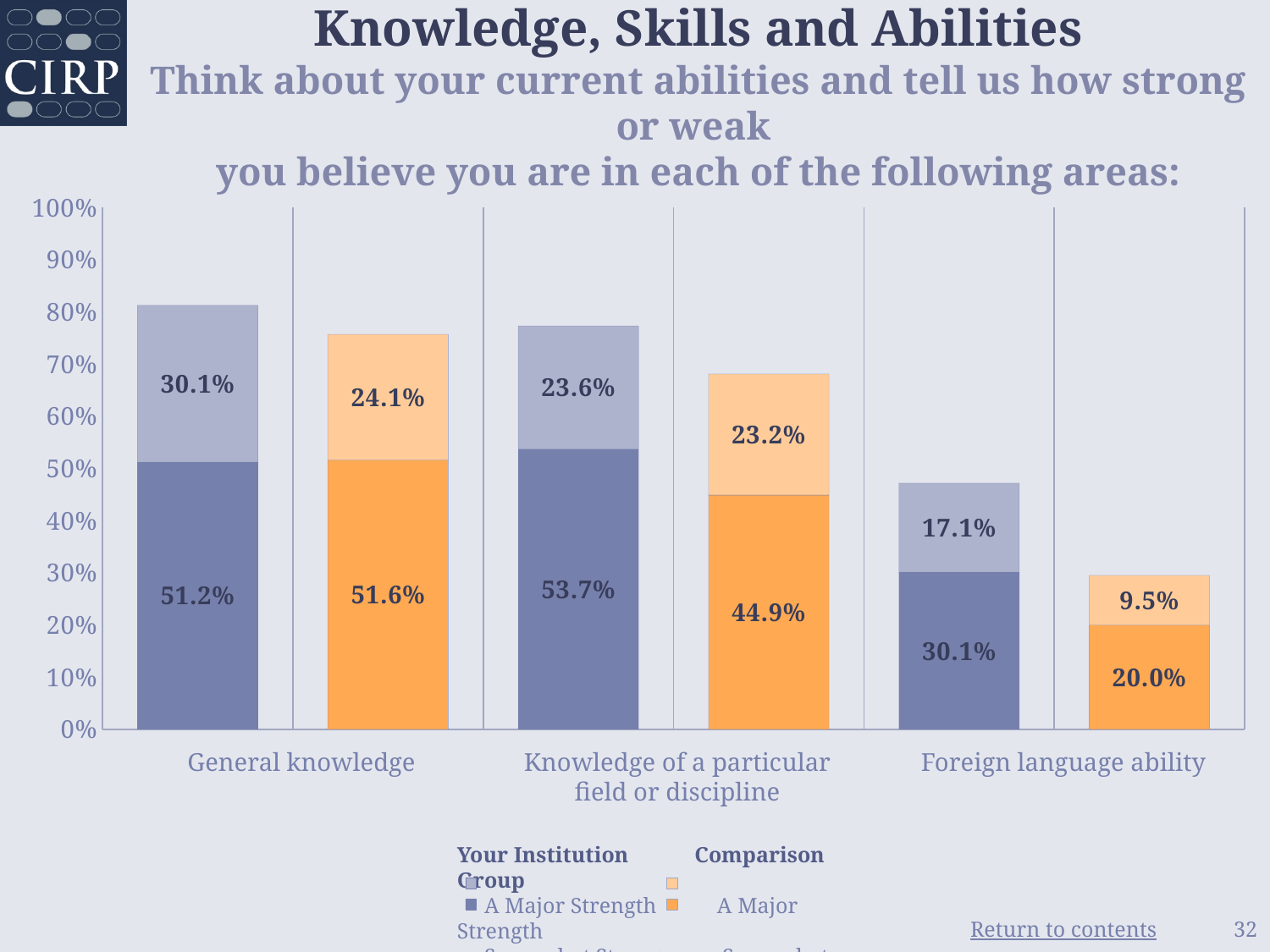
Which colour represents the Comparison Group in the chart? Orange Which category has the lowest A Major Strength value for the Comparison Group? Foreign language ability What is the total height of the Your Institution stacked bar for General knowledge? 81.3% For Foreign language ability, which is larger: Your Institution's A Major Strength value or the Comparison Group's A Major Strength value? Your Institution Which category has the highest A Major Strength value for Your Institution? Knowledge of a particular field or discipline What is the Somewhat Strength value for Your Institution in Knowledge of a particular field or discipline? 23.6% What type of chart is shown on the slide? Stacked bar chart What is the Comparison Group's A Major Strength value for Foreign language ability? 20.0% How many categories are shown on the x axis? 3 What percentage of Your Institution respondents rated General knowledge as A Major Strength? 51.2% What is the total height of the Comparison Group stacked bar for Foreign language ability? 29.5% What is the difference between Your Institution's and the Comparison Group's A Major Strength values for Knowledge of a particular field or discipline? 8.8%